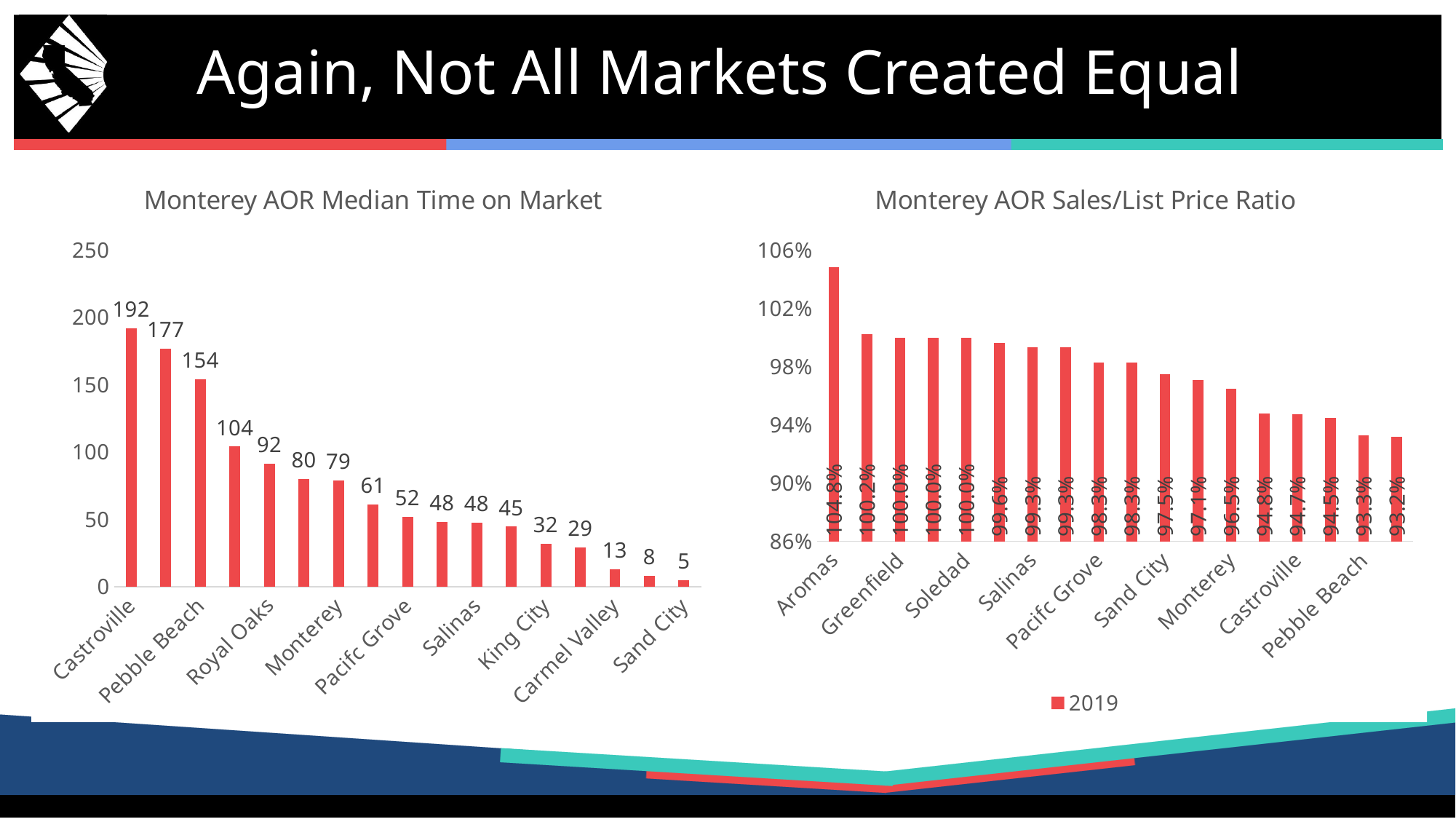
In the Monterey AOR Median Time on Market chart, what is the difference between the values for Castroville and Sand City? 187 How many series does the legend of the Monterey AOR Sales/List Price Ratio chart list? 1 In the Monterey AOR Median Time on Market chart, do the values rise or fall from left to right? fall In the Monterey AOR Median Time on Market chart, what is the median time on market for Castroville? 192 In the Monterey AOR Median Time on Market chart, what is the median time on market for Sand City? 5 In the Monterey AOR Sales/List Price Ratio chart, what is the sales/list price ratio for Aromas? 104.8% In the Monterey AOR Median Time on Market chart, which market has the lowest median time on market? Sand City In the Monterey AOR Median Time on Market chart, which market has the highest median time on market? Castroville What kind of chart is the Monterey AOR Median Time on Market chart? bar chart In the Monterey AOR Sales/List Price Ratio chart, which has the larger ratio, Aromas or Pebble Beach? Aromas How many bars are plotted in the Monterey AOR Median Time on Market chart? 17 In the Monterey AOR Sales/List Price Ratio chart, which market has the highest sales/list price ratio? Aromas